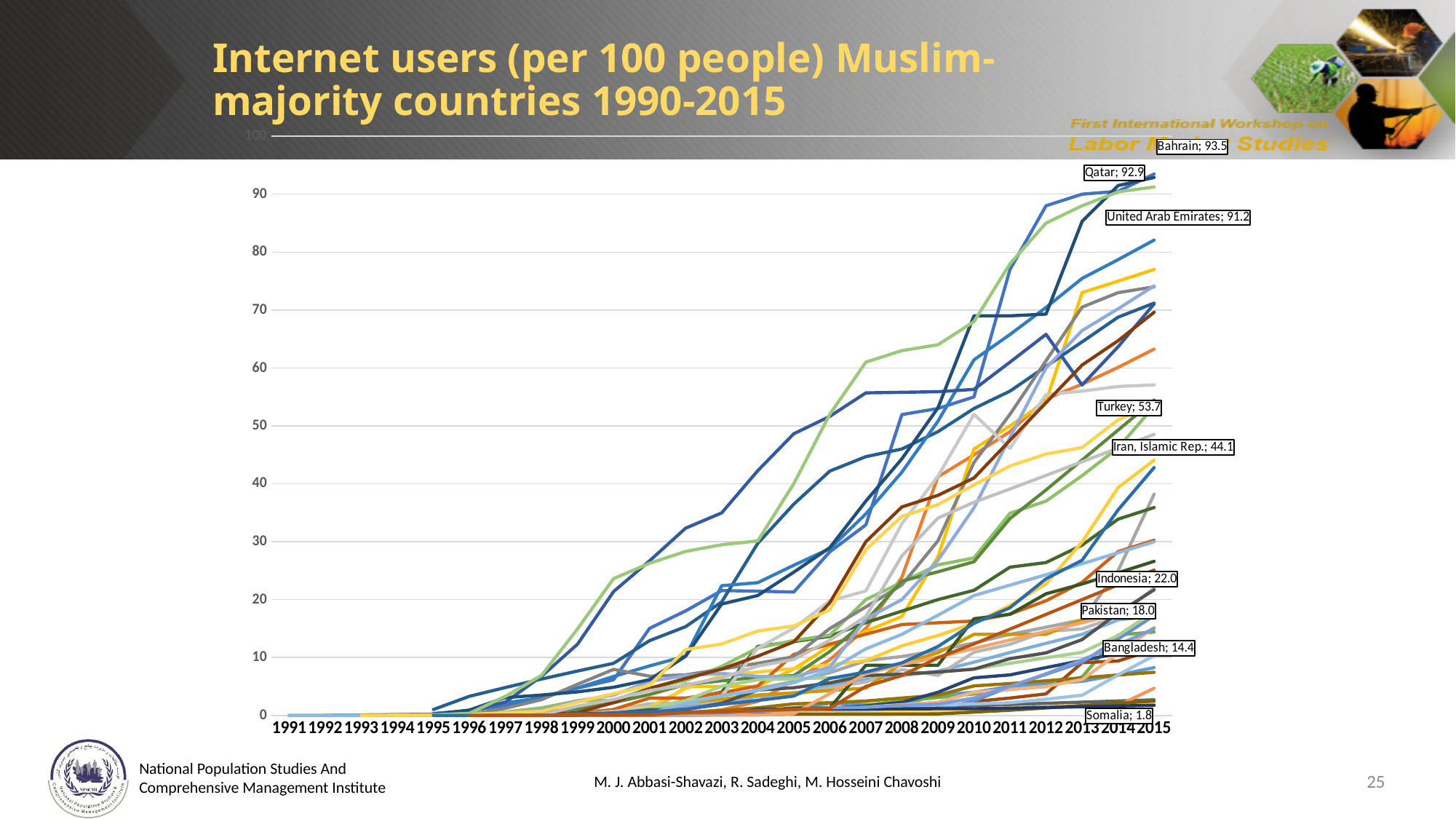
What is the 2015 value labelled for the United Arab Emirates? 91.2 Which country has the highest labelled value in 2015? Bahrain Do the values for Bahrain generally rise or fall from 1991 to 2015? Rise Which has a larger labelled 2015 value, Turkey or Iran, Islamic Rep.? Turkey What kind of chart is shown on the slide? Line chart What is the 2015 value labelled for Somalia? 1.8 What is the 2015 value labelled for Bahrain? 93.5 What is the 2015 value labelled for Iran, Islamic Rep.? 44.1 What is the difference between the labelled 2015 values for Indonesia and Pakistan? 4.0 What is the 2015 value labelled for Turkey? 53.7 What is the 2015 value labelled for Qatar? 92.9 How many years are shown on the x axis? 25